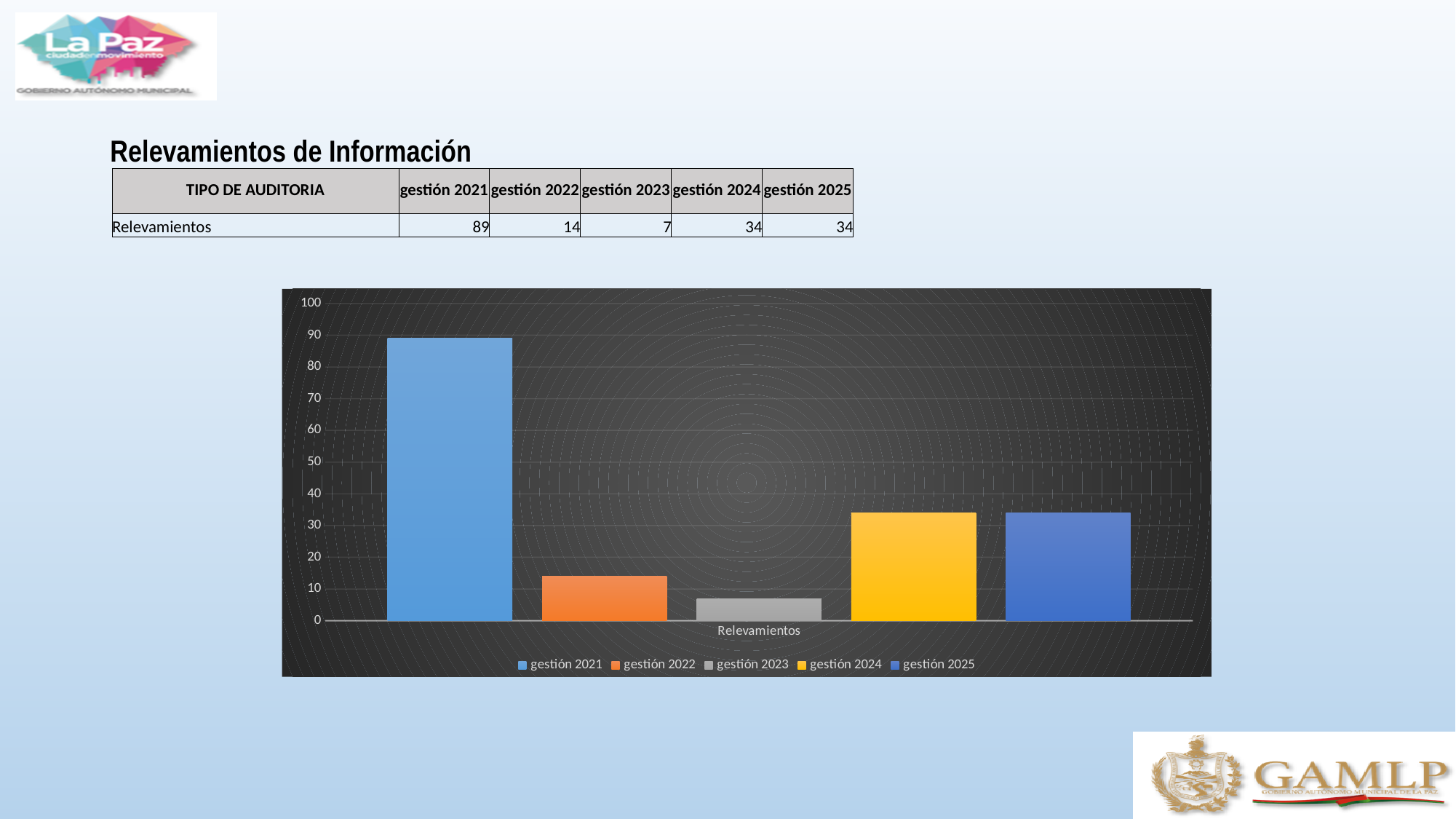
Is the value for gestión 2023 greater or less than 10? less What is the category label shown on the horizontal axis of the chart? Relevamientos How many series does the chart legend list? 5 What is the value of Relevamientos for gestión 2021? 89 What is the value of Relevamientos for gestión 2024? 34 What kind of chart is shown on the slide? bar chart Is the value for gestión 2021 greater or less than 80? greater Which is larger, the value for gestión 2022 or the value for gestión 2025? gestión 2025 Which series has the lowest value in the chart? gestión 2023 What is the value of Relevamientos for gestión 2023? 7 What is the difference between the Relevamientos values for gestión 2021 and gestión 2022? 75 Which series has the highest value in the chart? gestión 2021